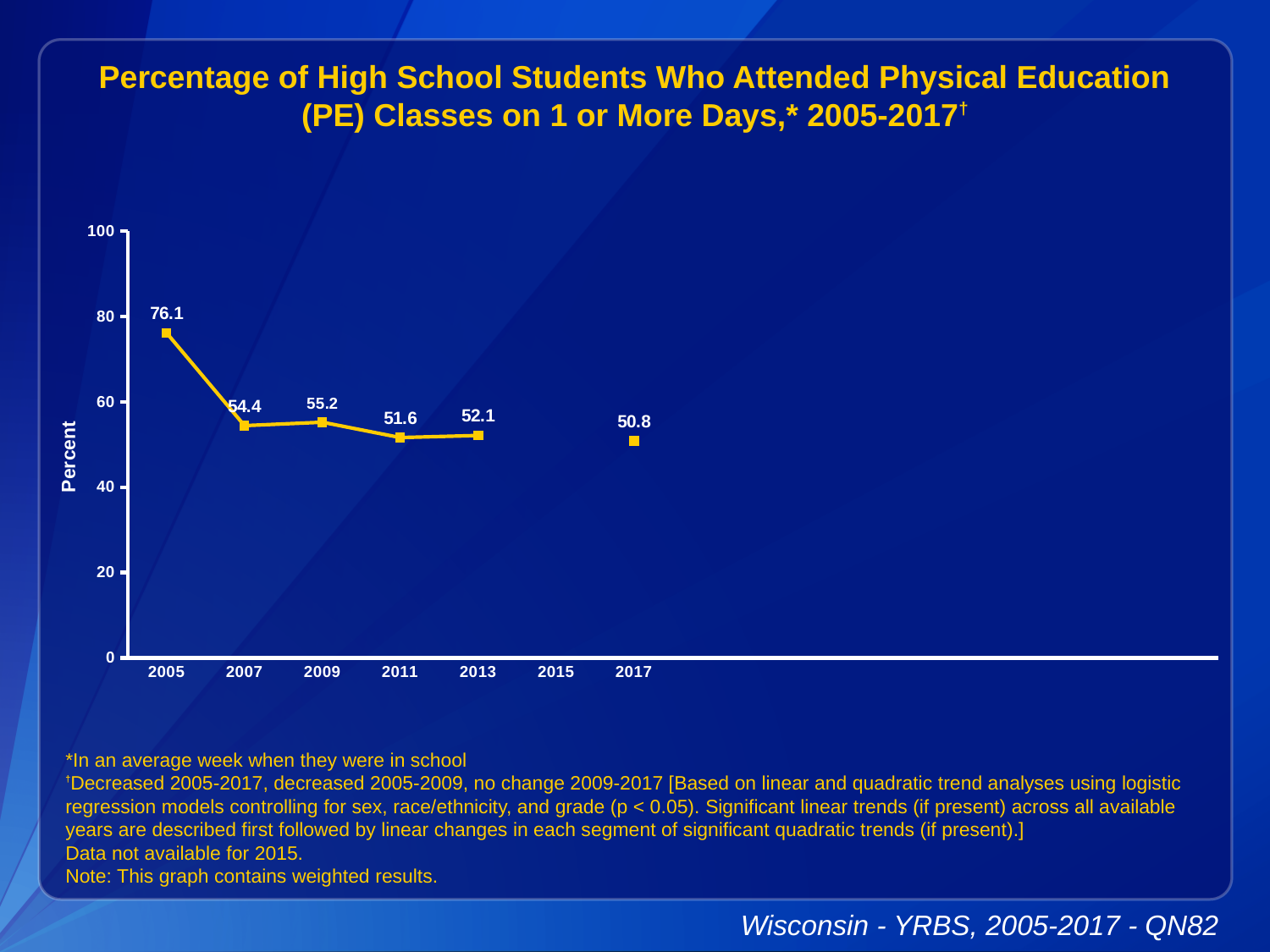
What is the label on the vertical axis? Percent What is the difference between the 2005 value and the 2007 value? 21.7 Which year has the lowest percentage? 2017 How many years have a data point plotted on the chart? 6 Is the value for 2005 greater or less than 60? greater What is the value plotted for 2017? 50.8 What kind of chart is shown on the slide? line chart Which is larger, the value for 2009 or the value for 2013? 2009 What is the value plotted for 2011? 51.6 What percentage of high school students attended PE classes on 1 or more days in 2005? 76.1 Which year has the highest percentage? 2005 Do the values generally rise or fall from 2005 to 2017? fall